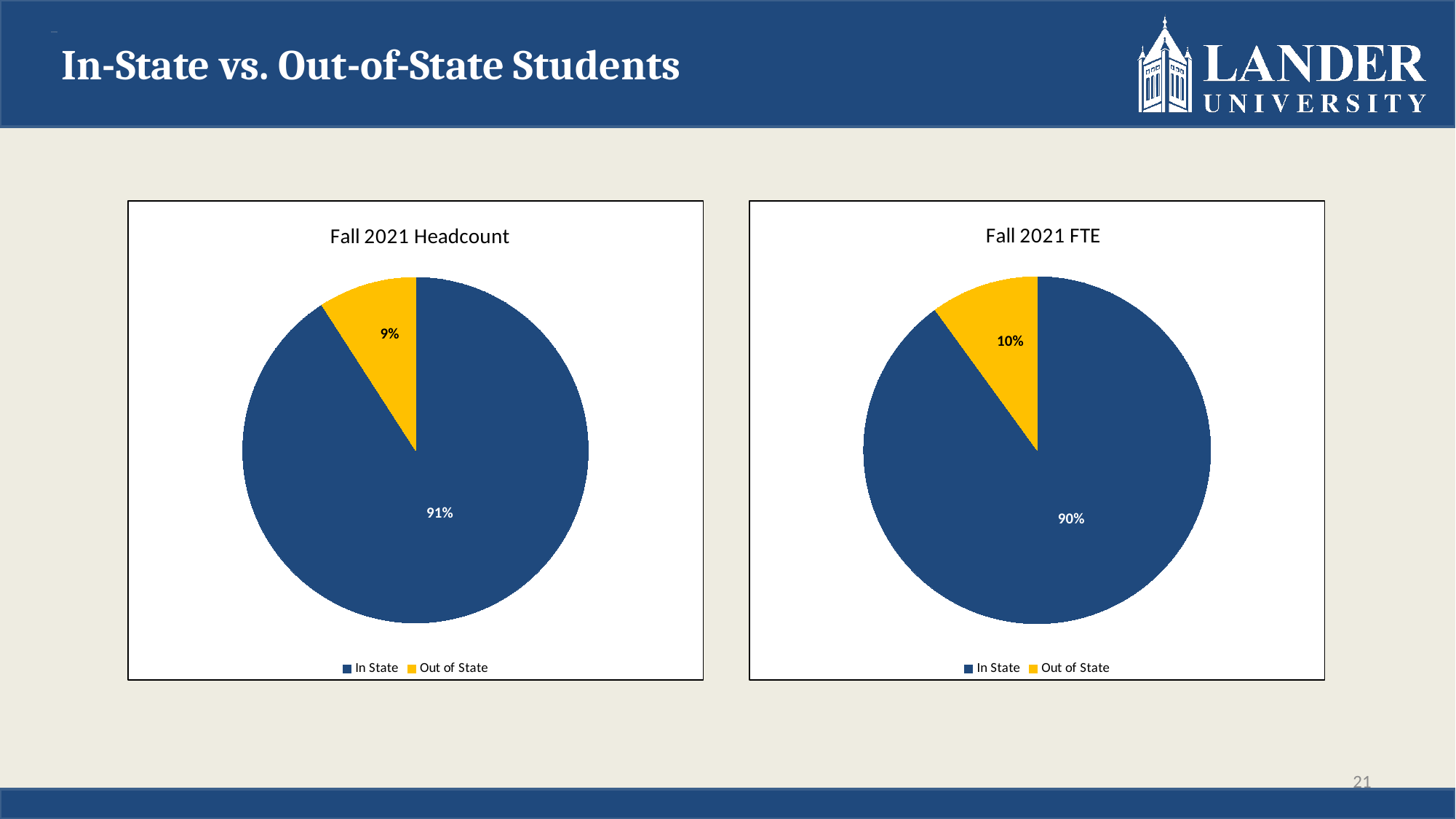
In the Fall 2021 Headcount chart, what percentage of students are Out of State? 9% How many categories does the legend of the Fall 2021 FTE chart list? 2 In the Fall 2021 FTE chart, what colour represents Out of State? Yellow In the Fall 2021 Headcount chart, which category has the largest share? In State What type of chart is the Fall 2021 Headcount chart? Pie chart In the Fall 2021 Headcount chart, what is the difference between the In State and Out of State shares? 82% In the Fall 2021 FTE chart, what percentage is Out of State? 10% In the Fall 2021 FTE chart, what percentage is In State? 90% How many slices does the Fall 2021 Headcount pie chart have? 2 In the Fall 2021 Headcount chart, what percentage of students are In State? 91% In the Fall 2021 FTE chart, which category has the smallest share? Out of State Is the Out of State share larger in the Fall 2021 Headcount chart or the Fall 2021 FTE chart? Fall 2021 FTE